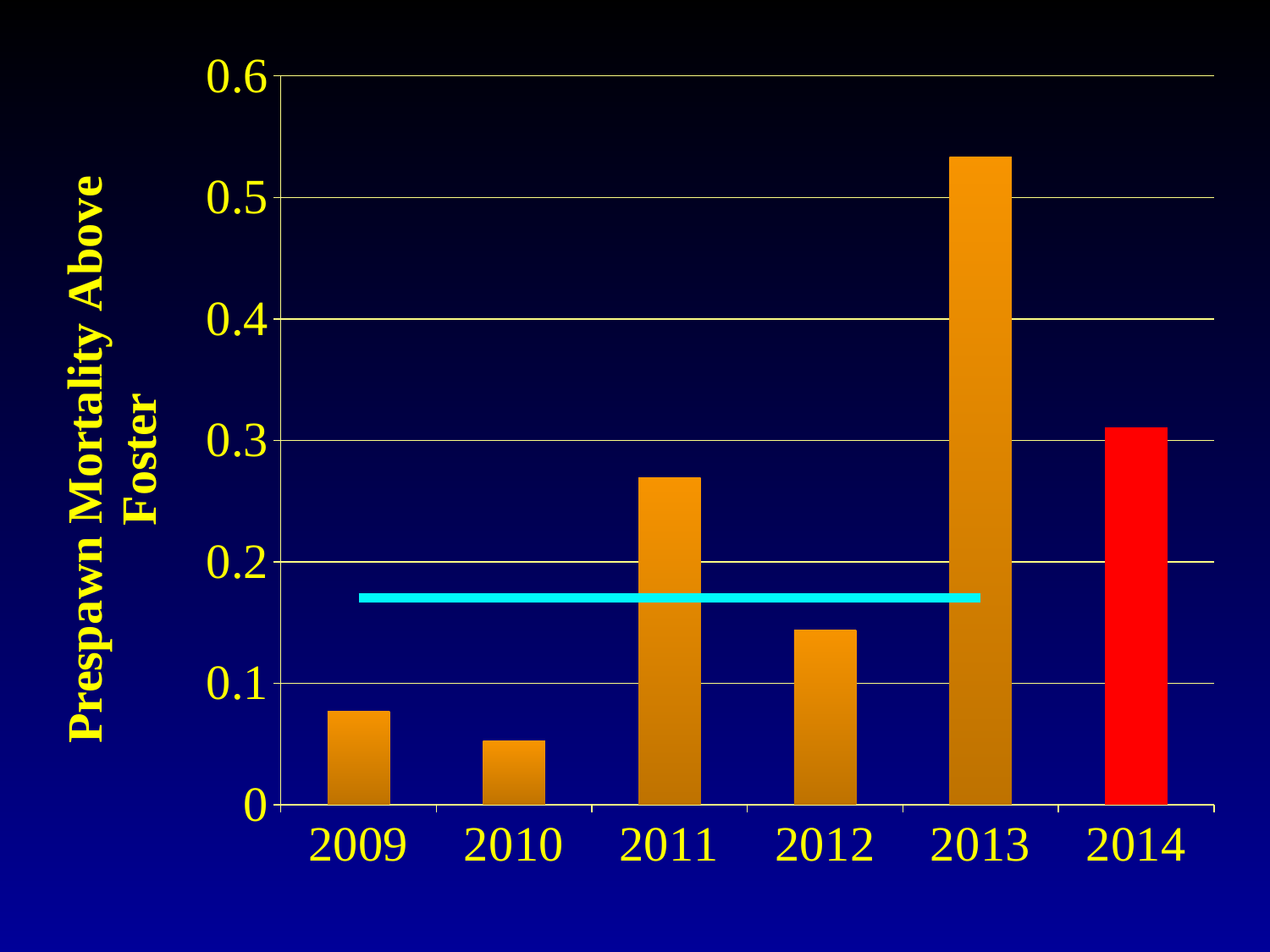
Is the value for 2013 greater or less than 0.5? greater Is the value for 2011 greater or less than 0.2? greater How many years are shown on the x axis? 6 What kind of chart is shown on the slide? bar chart Is the value for 2014 greater or less than 0.4? less Which year has the lowest prespawn mortality above Foster? 2010 What is the title of the vertical axis? Prespawn Mortality Above Foster Which year has the larger value, 2011 or 2012? 2011 Which year has the larger value, 2014 or 2013? 2013 Which year has the highest prespawn mortality above Foster? 2013